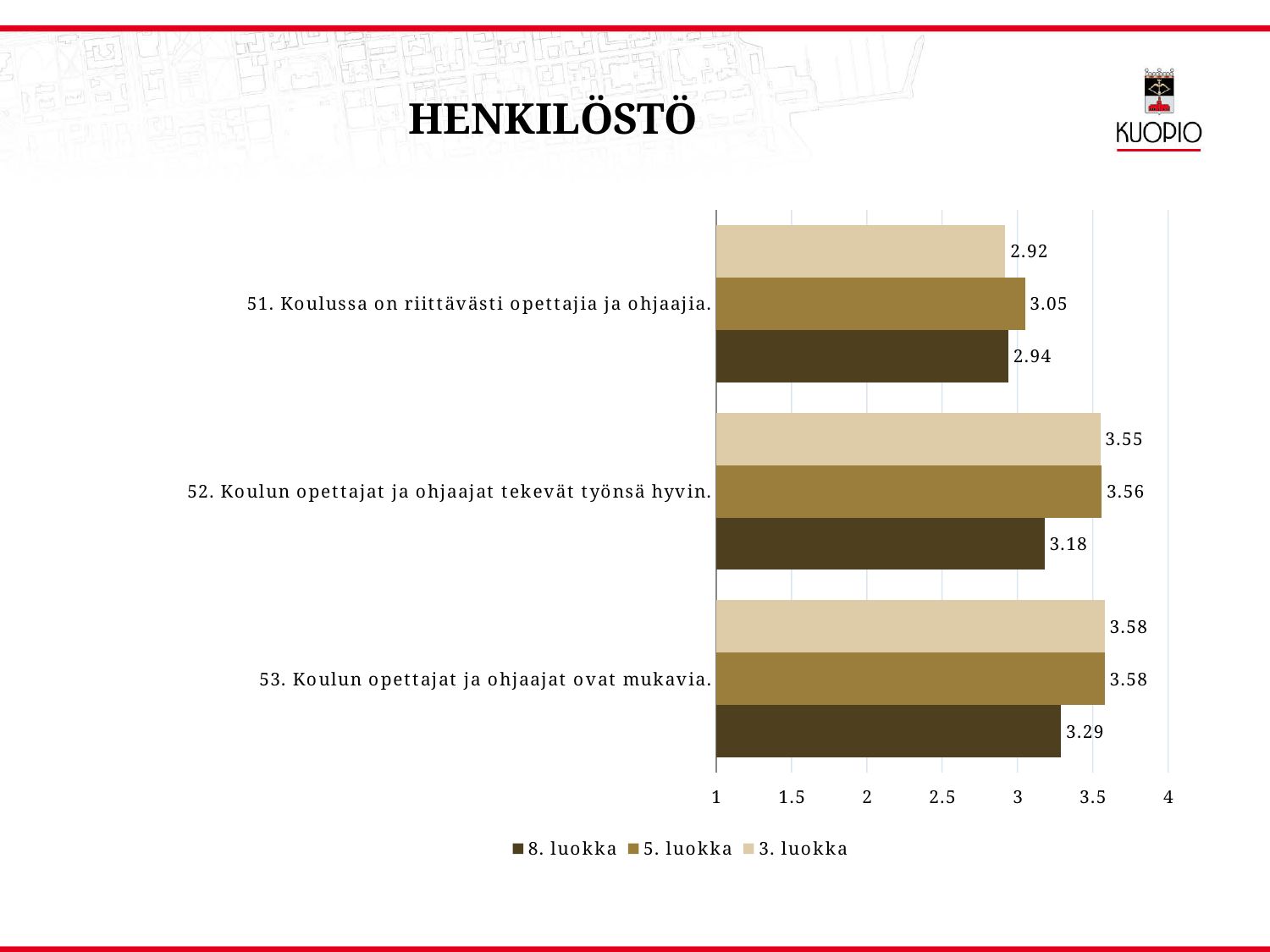
What is the value for 8. luokka for statement 52 (Koulun opettajat ja ohjaajat tekevät työnsä hyvin)? 3.18 How many categories (statements) are shown on the chart? 3 For statement 51, which is larger: the value for 5. luokka or the value for 3. luokka? 5. luokka How many series does the legend list? 3 What is the value for 3. luokka for statement 53 (Koulun opettajat ja ohjaajat ovat mukavia)? 3.58 What kind of chart is shown on the slide? bar chart What is the value for 5. luokka for statement 51 (Koulussa on riittävästi opettajia ja ohjaajia)? 3.05 Which series is shown in the darkest brown colour? 8. luokka Which statement has the highest value for 8. luokka? 53. Koulun opettajat ja ohjaajat ovat mukavia. Is the value for 8. luokka for statement 51 greater or less than 3? less What is the difference between the 5. luokka and 8. luokka values for statement 52? 0.38 Which statement has the lowest value for 3. luokka? 51. Koulussa on riittävästi opettajia ja ohjaajia.